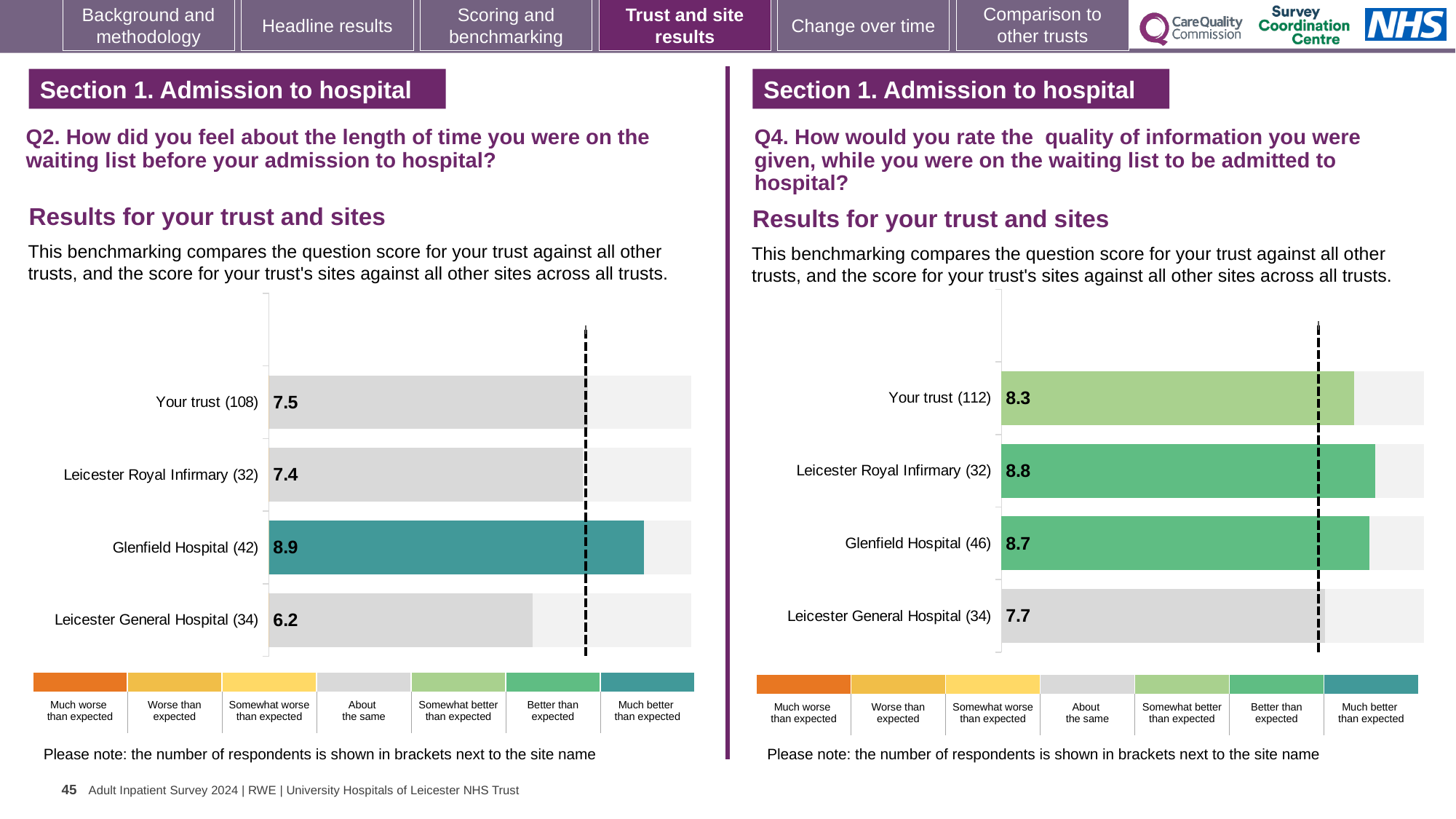
In the Q2 chart on the left, which site or trust has the lowest score? Leicester General Hospital In the Q4 chart on the right, which site or trust has the highest score? Leicester Royal Infirmary What type of chart is used on the right for Q4? Bar chart In the Q4 chart on the right, which has the higher score: Glenfield Hospital or Leicester General Hospital? Glenfield Hospital In the Q2 chart on the left, which has the higher score: Your trust or Leicester General Hospital? Your trust In the Q4 chart on the right, which benchmark category does the colour of the Your trust bar correspond to according to the legend? Somewhat better than expected In the Q4 chart on the right, what is the score for Leicester General Hospital? 7.7 In the Q2 chart on the left, what is the score for Glenfield Hospital? 8.9 In the Q2 chart on the left, how many respondents are shown in brackets for Your trust? 108 How many bars are shown in the Q2 chart on the left? 4 In the Q2 chart on the left, what is the difference between the scores for Glenfield Hospital and Leicester General Hospital? 2.7 In the Q4 chart on the right, what is the difference between the scores for Your trust and Leicester Royal Infirmary? 0.5